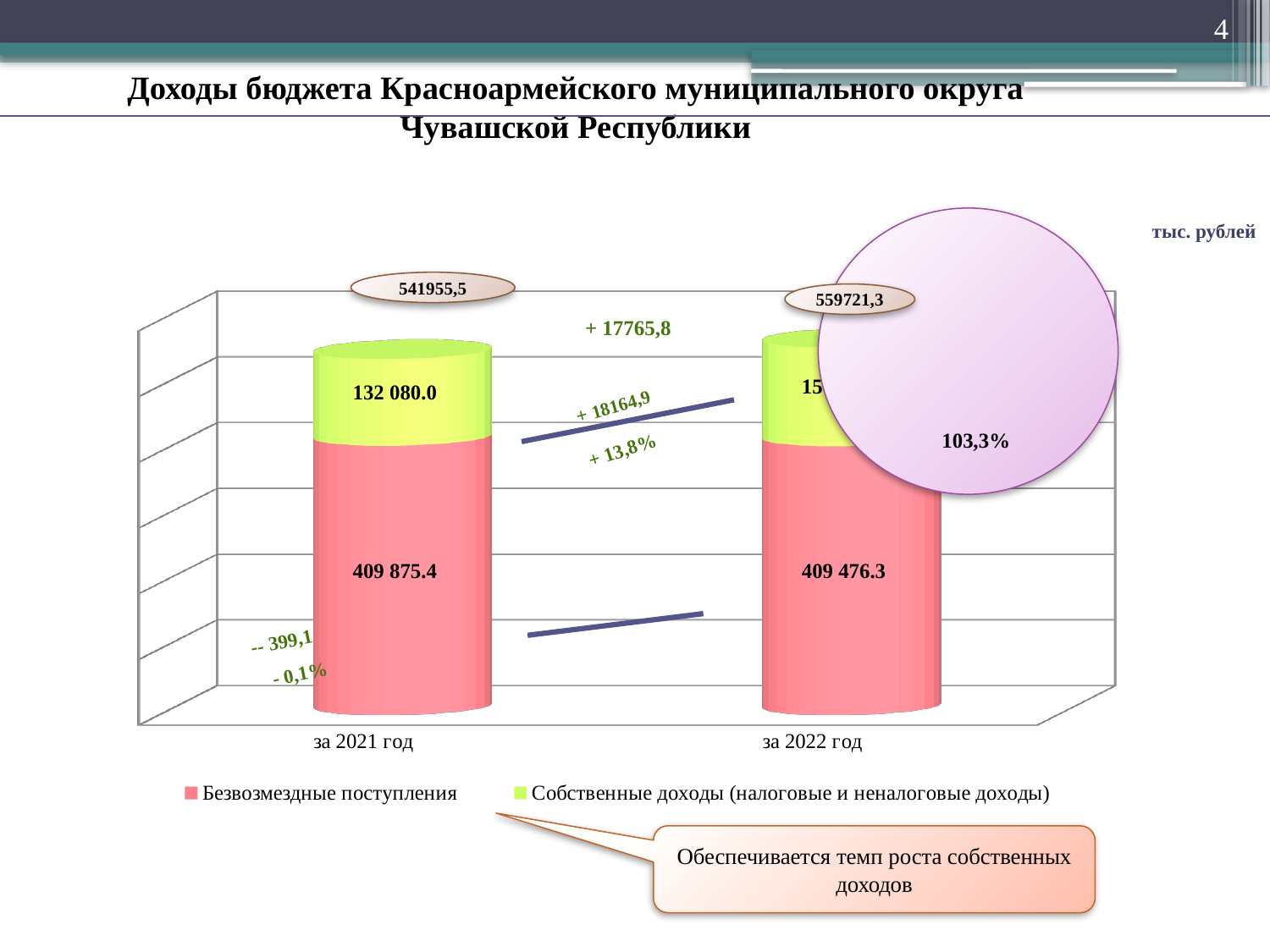
Which year has the higher total budget income? за 2022 год What is the value of Безвозмездные поступления for за 2021 год? 409 875.4 Which series is shown in green in the legend? Собственные доходы (налоговые и неналоговые доходы) How many series does the legend list? 2 What is the value of Собственные доходы (налоговые и неналоговые доходы) for за 2021 год? 132 080.0 What is the difference between the total for за 2022 год and the total for за 2021 год? 17765,8 What is the total of the stacked bar for за 2021 год? 541955,5 What kind of chart is shown on the slide? Stacked bar chart What is the difference between Безвозмездные поступления for за 2021 год and for за 2022 год? 399,1 What is the total of the stacked bar for за 2022 год? 559721,3 How many categories (years) are shown on the x axis? 2 What is the value of Безвозмездные поступления for за 2022 год? 409 476.3